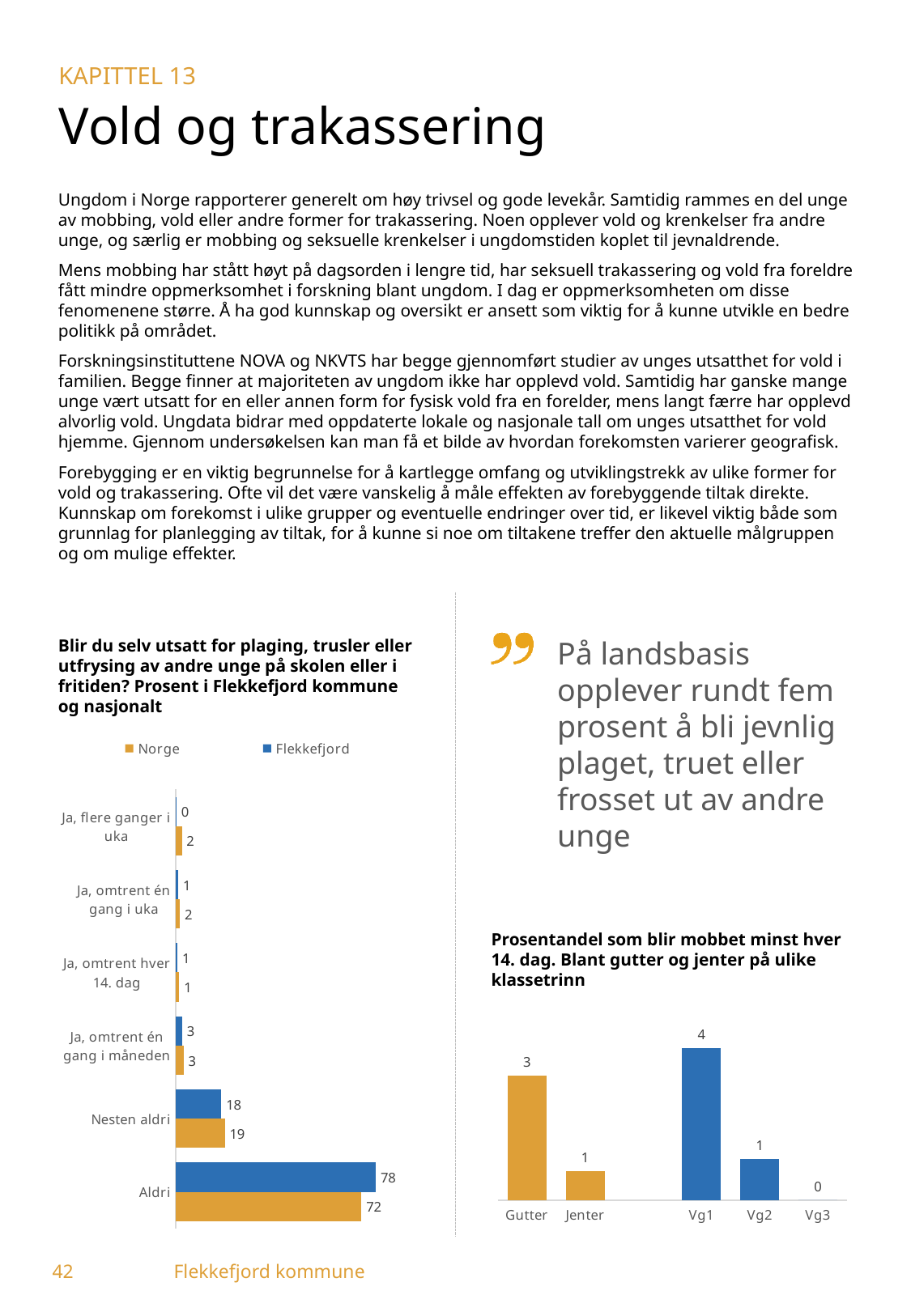
In the chart 'Prosentandel som blir mobbet minst hver 14. dag', what is the value for Vg1? 4 In the chart 'Blir du selv utsatt for plaging, trusler eller utfrysing av andre unge på skolen eller i fritiden?', what is the value for Flekkefjord in the 'Aldri' category? 78 In the chart 'Blir du selv utsatt for plaging, trusler eller utfrysing av andre unge på skolen eller i fritiden?', what is the difference between Flekkefjord and Norge in the 'Aldri' category? 6 What kind of chart is 'Prosentandel som blir mobbet minst hver 14. dag'? Bar chart In the chart 'Blir du selv utsatt for plaging, trusler eller utfrysing av andre unge på skolen eller i fritiden?', what is the value for Norge in the 'Nesten aldri' category? 19 In the chart 'Prosentandel som blir mobbet minst hver 14. dag', which is larger, Gutter or Jenter? Gutter In the chart 'Blir du selv utsatt for plaging, trusler eller utfrysing av andre unge på skolen eller i fritiden?', which colour represents Flekkefjord? Blue In the chart 'Blir du selv utsatt for plaging, trusler eller utfrysing av andre unge på skolen eller i fritiden?', which category has the highest value for Norge? Aldri In the chart 'Blir du selv utsatt for plaging, trusler eller utfrysing av andre unge på skolen eller i fritiden?', how many series does the legend list? 2 In the chart 'Blir du selv utsatt for plaging, trusler eller utfrysing av andre unge på skolen eller i fritiden?', what is the value for Flekkefjord in the 'Ja, flere ganger i uka' category? 0 In the chart 'Prosentandel som blir mobbet minst hver 14. dag', which category has the lowest value? Vg3 In the chart 'Blir du selv utsatt for plaging, trusler eller utfrysing av andre unge på skolen eller i fritiden?', how many categories are shown? 6